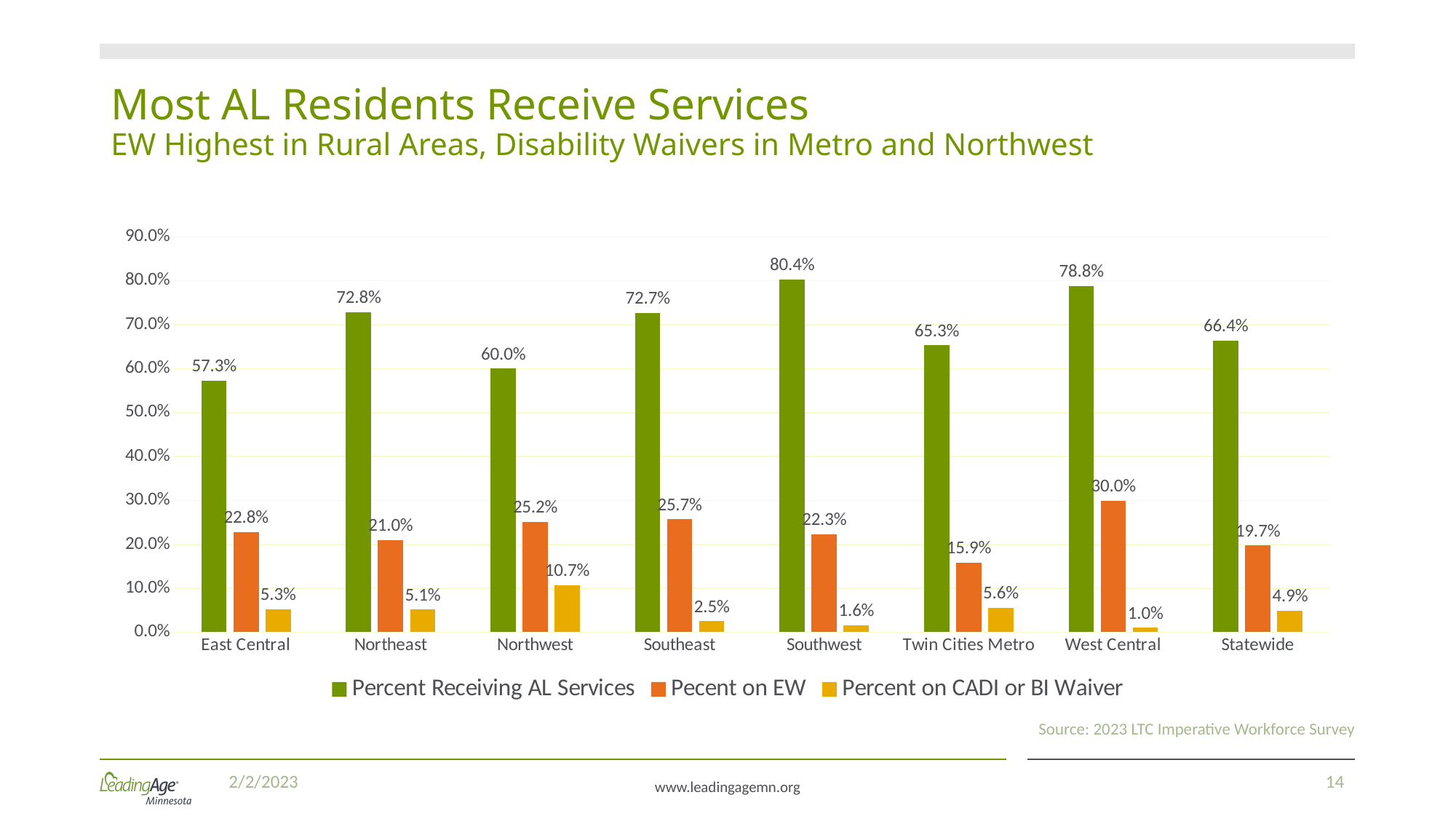
Is the Percent Receiving AL Services for Twin Cities Metro greater or less than 70.0%? less What is the Pecent on EW for West Central? 30.0% What is the Percent on CADI or BI Waiver for Northwest? 10.7% Which is larger: the Pecent on EW for Northeast or for Southeast? Southeast Which region has the highest Percent Receiving AL Services? Southwest Which region has the lowest Percent on CADI or BI Waiver? West Central What kind of chart is shown on the slide? Bar chart How many regions (categories) are shown on the x axis? 8 What is the source cited for the chart? 2023 LTC Imperative Workforce Survey How many series does the legend list? 3 What is the Percent Receiving AL Services for Southwest? 80.4% What is the difference between the Percent Receiving AL Services for Southwest and East Central? 23.1%